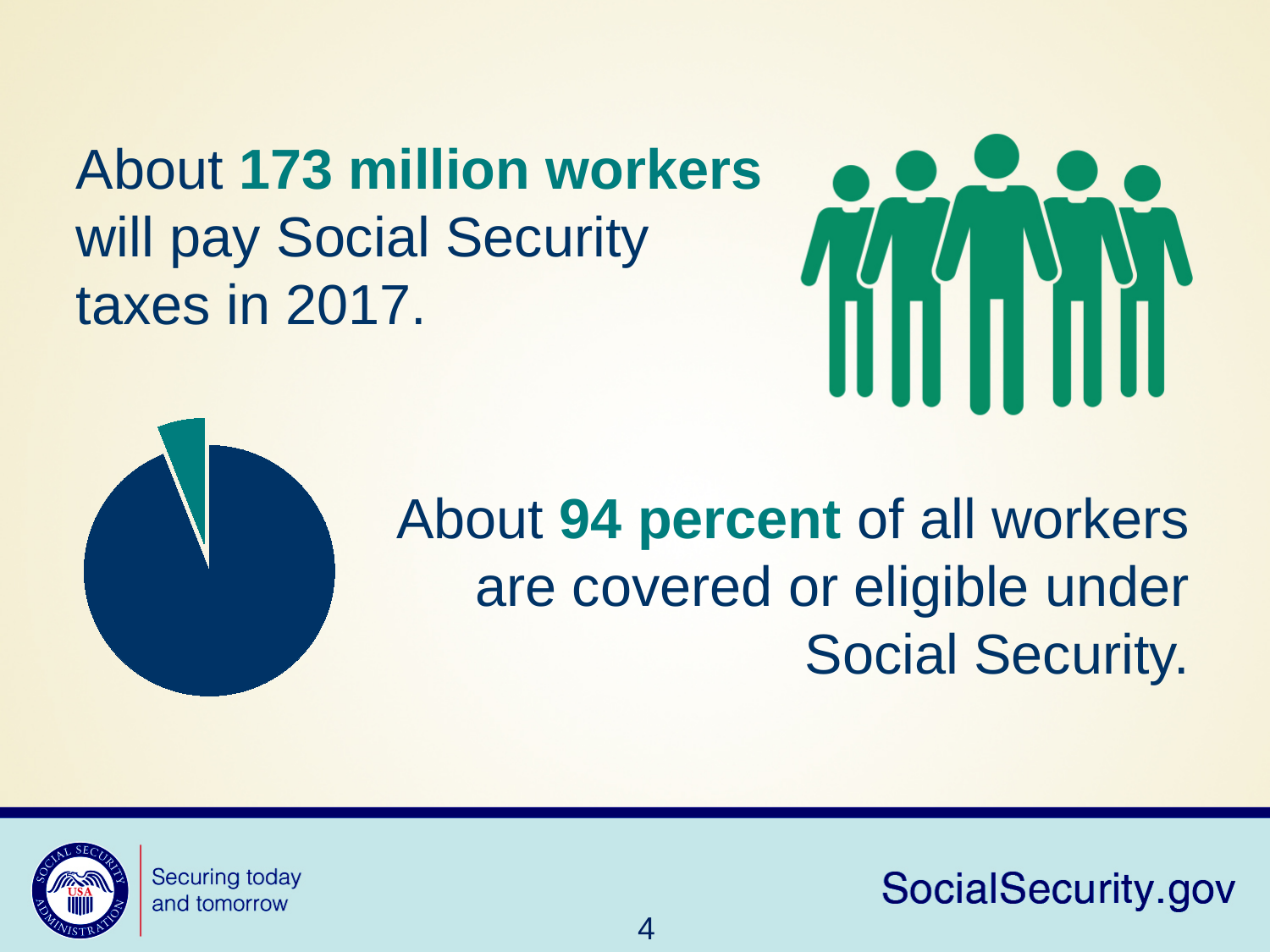
What colour is the small slice that is pulled out from the pie chart? teal What kind of chart is shown on the slide? pie chart Does the pie chart display a legend? No Which slice of the pie chart is the largest? the dark blue slice Which slice of the pie chart is the smallest? the teal slice Which slice of the pie chart is larger, the dark blue slice or the teal slice? the dark blue slice Does the dark blue slice cover more or less than half of the pie chart? more How many slices does the pie chart have? 2